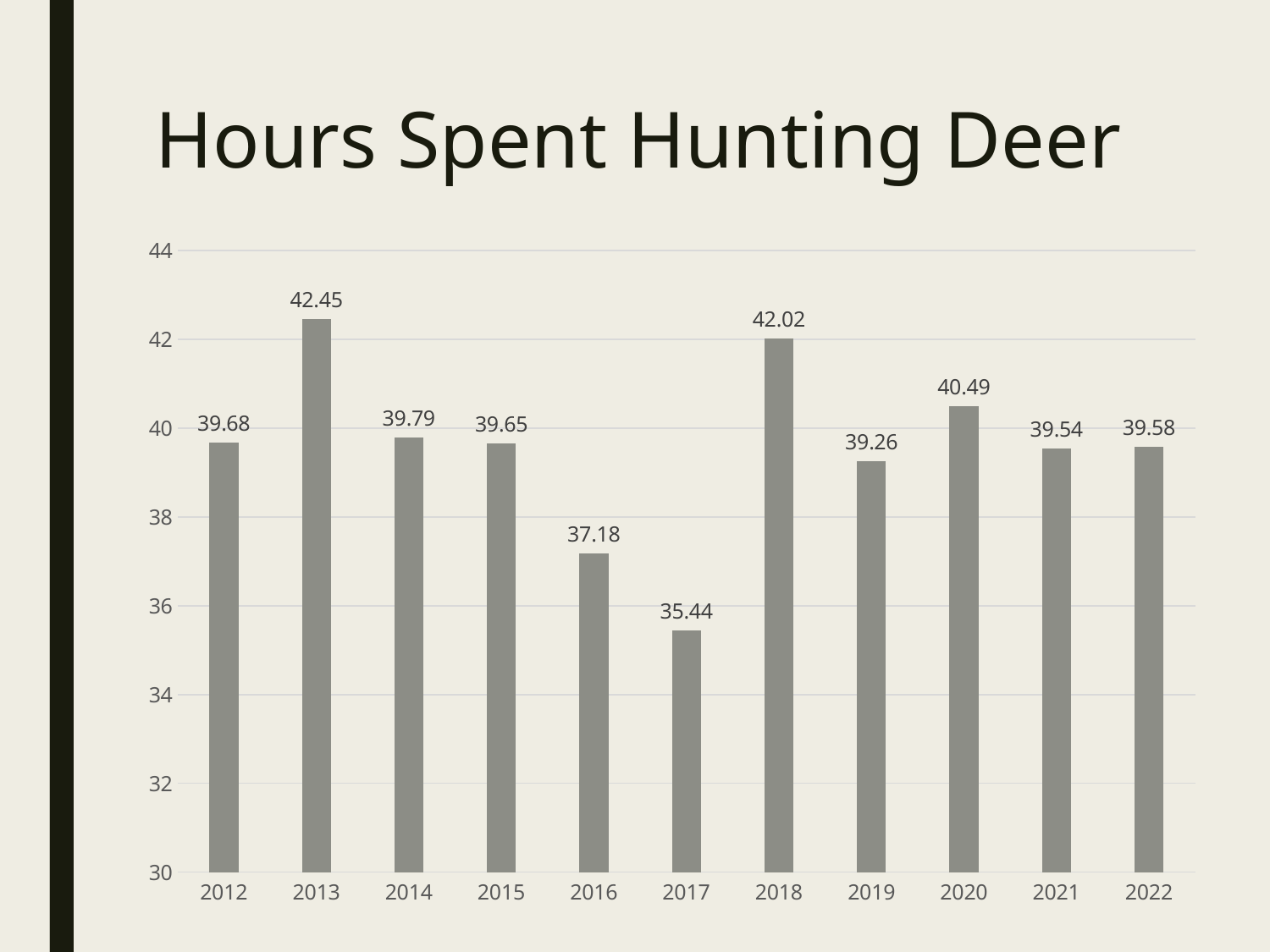
Which year has the lowest value? 2017 Which year has the highest value? 2013 What is the value for 2020? 40.49 What is the difference between the values for 2013 and 2017? 7.01 What kind of chart is shown on the slide? bar chart Is the value for 2016 greater or less than 38? less What is the title of the chart? Hours Spent Hunting Deer How many years are shown on the x axis? 11 What is the difference between the values for 2018 and 2016? 4.84 What is the value for 2017? 35.44 Which is larger, the value for 2018 or the value for 2020? 2018 What is the value for 2013? 42.45